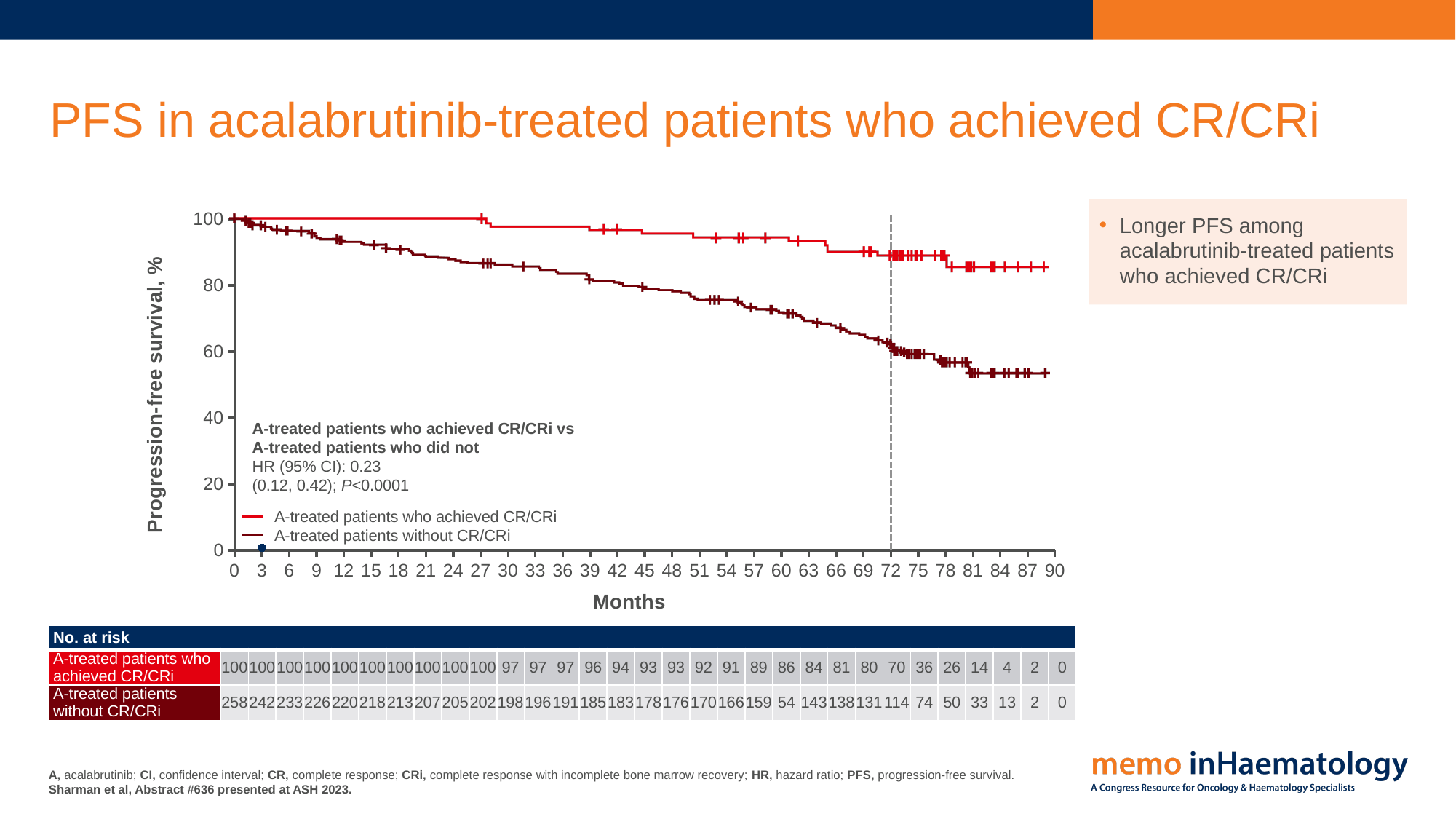
What kind of chart is shown on the slide? line chart At 60 months, which curve shows higher progression-free survival: A-treated patients who achieved CR/CRi or A-treated patients without CR/CRi? A-treated patients who achieved CR/CRi Is the progression-free survival for A-treated patients who achieved CR/CRi at 72 months greater or less than 80%? greater At month 0, what is the difference in the number at risk between A-treated patients without CR/CRi and those who achieved CR/CRi? 158 How many series does the legend list? 2 According to the No. at risk table, how many A-treated patients without CR/CRi were at risk at month 0? 258 Do the progression-free survival curves rise or fall as months increase? fall According to the No. at risk table, how many A-treated patients without CR/CRi were at risk at 84 months? 13 What hazard ratio is reported on the chart for A-treated patients who achieved CR/CRi vs those who did not? 0.23 Is the progression-free survival for A-treated patients without CR/CRi at 72 months greater or less than 80%? less What is the label of the x axis? Months According to the No. at risk table, how many A-treated patients who achieved CR/CRi were at risk at 72 months? 70